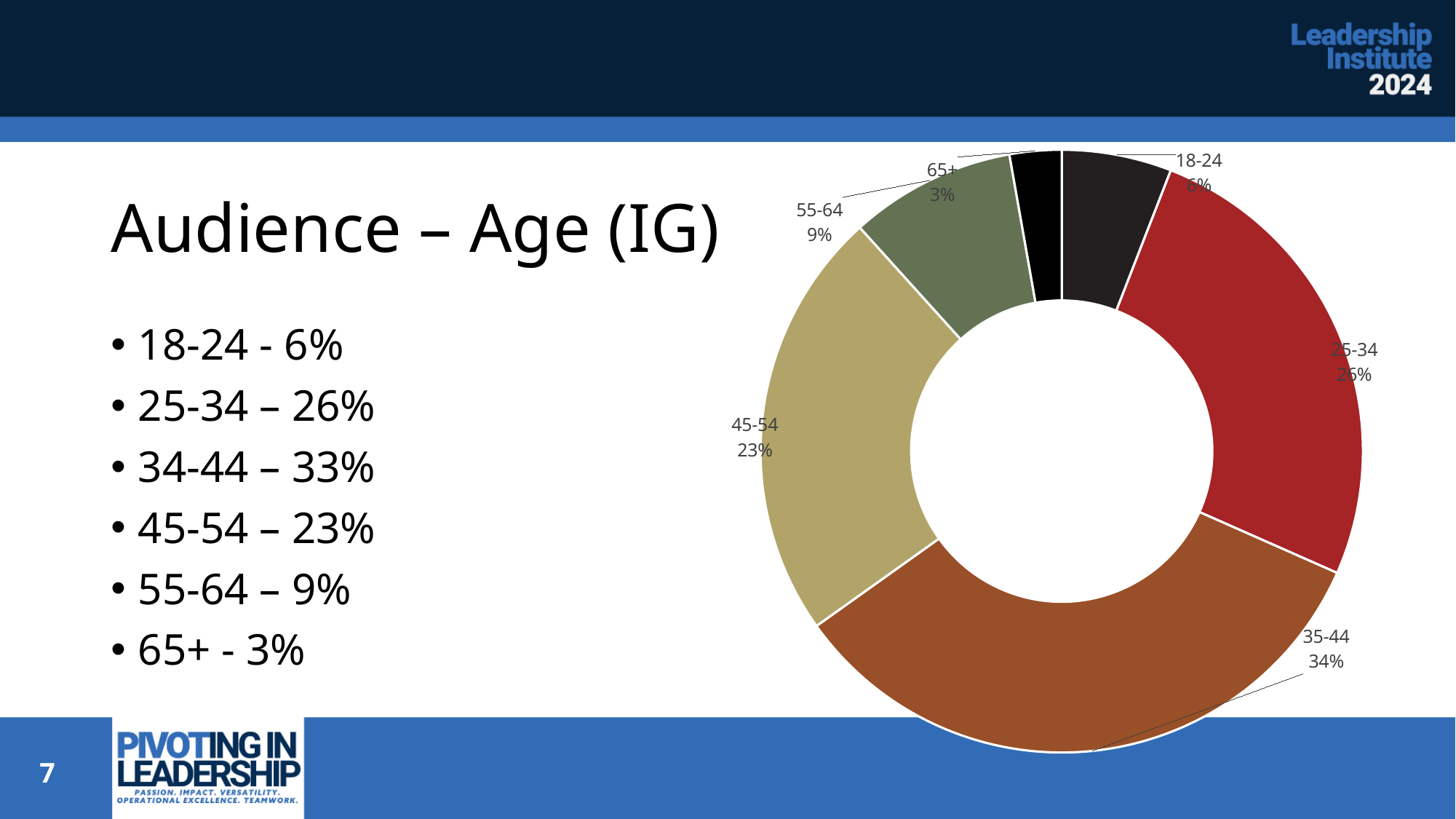
According to the chart's data label, what share of the audience is aged 18-24? 6% Based on the chart's data labels, what is the difference between the 25-34 share and the 18-24 share? 20% According to the chart's data label, what share of the audience is aged 45-54? 23% According to the chart's data label, what share of the audience is aged 55-64? 9% How many age groups are shown in the chart? 6 Which age group has the smallest slice in the chart? 65+ Based on the chart's data labels, what is the difference between the 55-64 share and the 65+ share? 6% Which age group has the largest slice in the chart? 35-44 According to the chart's data label, what share of the audience is aged 25-34? 26% What kind of chart is shown on the slide? Doughnut chart Which slice is larger in the chart, 25-34 or 45-54? 25-34 What is the title of the slide containing the chart? Audience – Age (IG)